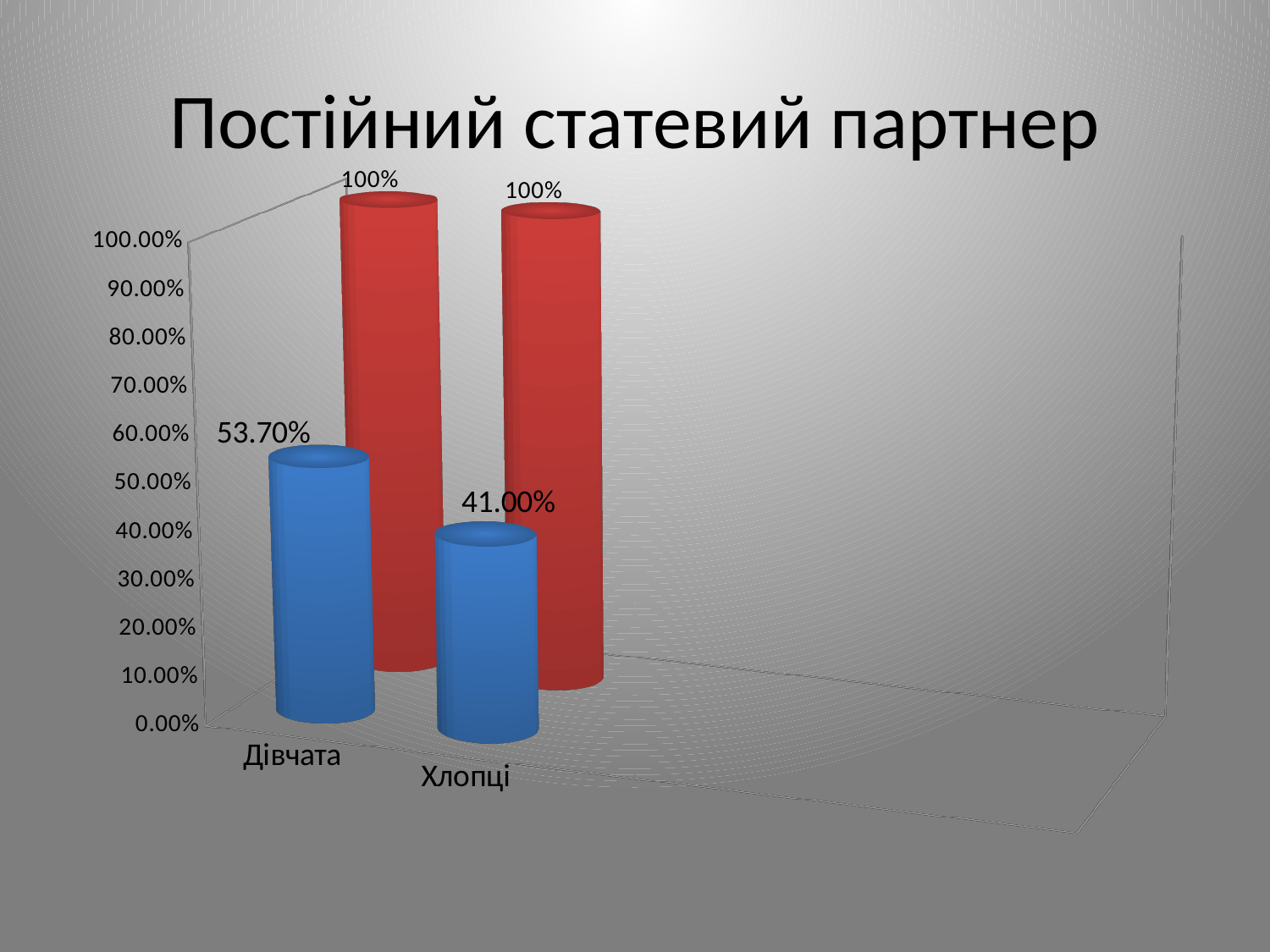
Which category has the lowest blue bar value? Хлопці What is the value of the red bar for Хлопці? 100% Is the blue bar value for Хлопці greater or less than 50.00%? less What is the value of the blue bar for Хлопці? 41.00% What is the value of the red bar for Дівчата? 100% What is the title of the chart? Постійний статевий партнер What kind of chart is shown on the slide? Bar chart What is the value of the blue bar for Дівчата? 53.70% How many categories are shown on the x axis? 2 What is the difference between the blue bar values for Дівчата and Хлопці? 12.70% Which category has the higher blue bar, Дівчата or Хлопці? Дівчата What is the highest value shown on the vertical axis? 100.00%